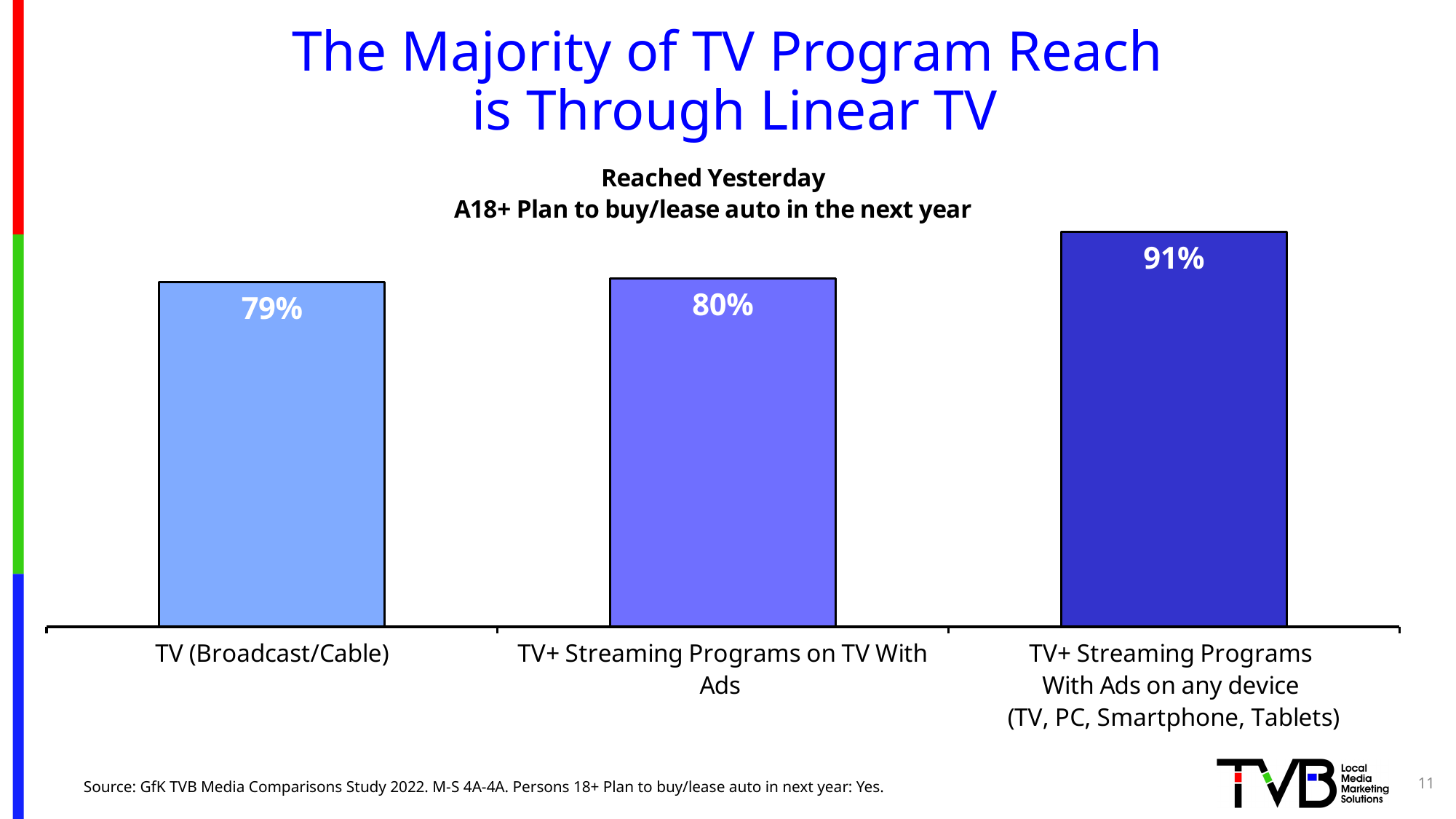
Do the values rise or fall from left to right across the categories? Rise Which is larger: the value for TV (Broadcast/Cable) or the value for TV+ Streaming Programs With Ads on any device? TV+ Streaming Programs With Ads on any device What is the difference between the value for TV+ Streaming Programs on TV With Ads and the value for TV (Broadcast/Cable)? 1% What is the value for TV+ Streaming Programs With Ads on any device (TV, PC, Smartphone, Tablets)? 91% What is the value for TV+ Streaming Programs on TV With Ads? 80% Which category has the lowest value? TV (Broadcast/Cable) What is the value for TV (Broadcast/Cable)? 79% What is the difference between the value for TV+ Streaming Programs With Ads on any device and the value for TV (Broadcast/Cable)? 12% What kind of chart is shown on the slide? Bar chart Which category has the highest value? TV+ Streaming Programs With Ads on any device (TV, PC, Smartphone, Tablets) How many categories are shown in the chart? 3 What is the title of the chart? Reached Yesterday A18+ Plan to buy/lease auto in the next year